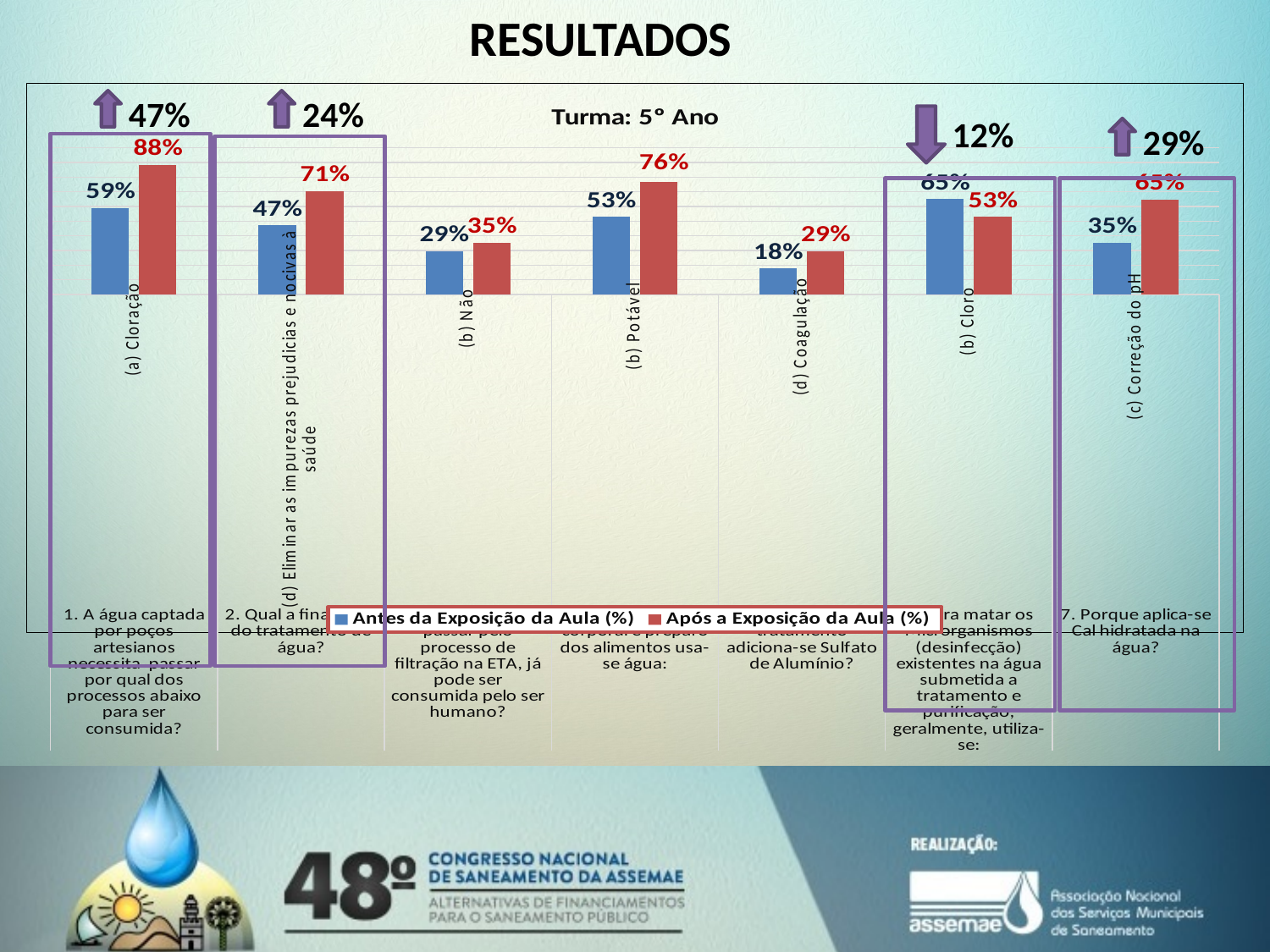
What is the title of the chart? Turma: 5° Ano Which category has the highest 'Após a Exposição da Aula (%)' value? (a) Cloração Which category has the lowest 'Antes da Exposição da Aula (%)' value? (d) Coagulação How many series does the chart legend list? 2 What is the value of 'Após a Exposição da Aula (%)' for (b) Potável? 76% What is the value of 'Antes da Exposição da Aula (%)' for (a) Cloração? 59% What kind of chart is shown on the slide? bar chart How many categories are plotted along the x axis of the chart? 7 What is the value of 'Após a Exposição da Aula (%)' for (a) Cloração? 88% For (b) Cloro, which is larger: the 'Antes da Exposição da Aula (%)' value or the 'Após a Exposição da Aula (%)' value? Antes da Exposição da Aula (%) What is the value of 'Antes da Exposição da Aula (%)' for (d) Coagulação? 18% What is the difference between the 'Após' and 'Antes' values for (b) Potável? 23%